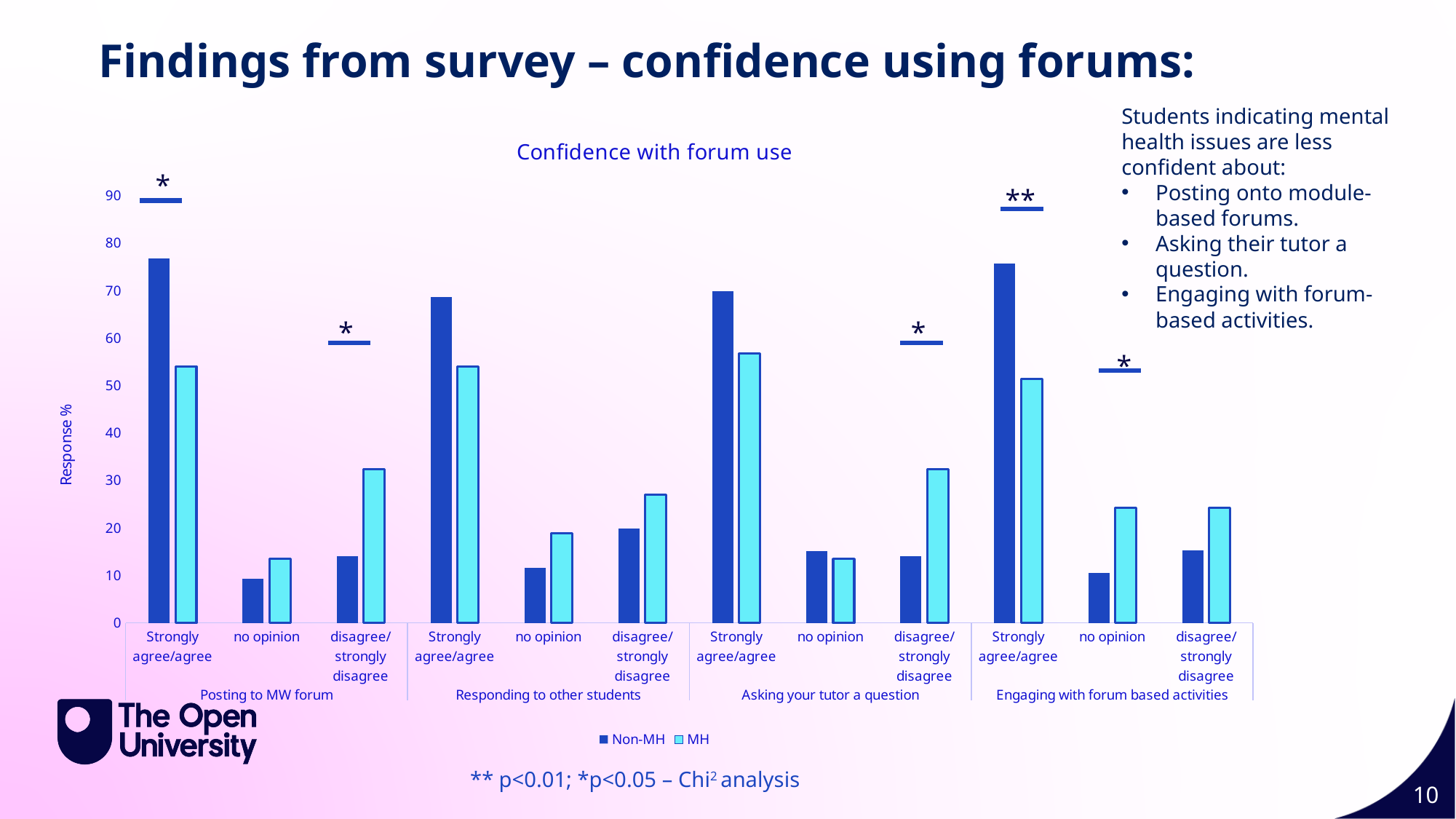
For Strongly agree/agree under Posting to MW forum, which series has the larger value, Non-MH or MH? Non-MH Is the Non-MH value for Strongly agree/agree under Posting to MW forum greater or less than 70? greater How many series does the legend list? 2 How many forum activity groups are shown along the x axis? 4 For no opinion under Engaging with forum based activities, which series has the larger value, Non-MH or MH? MH What is the title of the chart? Confidence with forum use Is the MH value for Strongly agree/agree under Engaging with forum based activities greater or less than 60? less Is the MH value for disagree/strongly disagree under Posting to MW forum greater or less than 20? greater What kind of chart is shown on the slide? bar chart What are the two series named in the legend? Non-MH and MH For disagree/strongly disagree under Asking your tutor a question, which series has the larger value, Non-MH or MH? MH